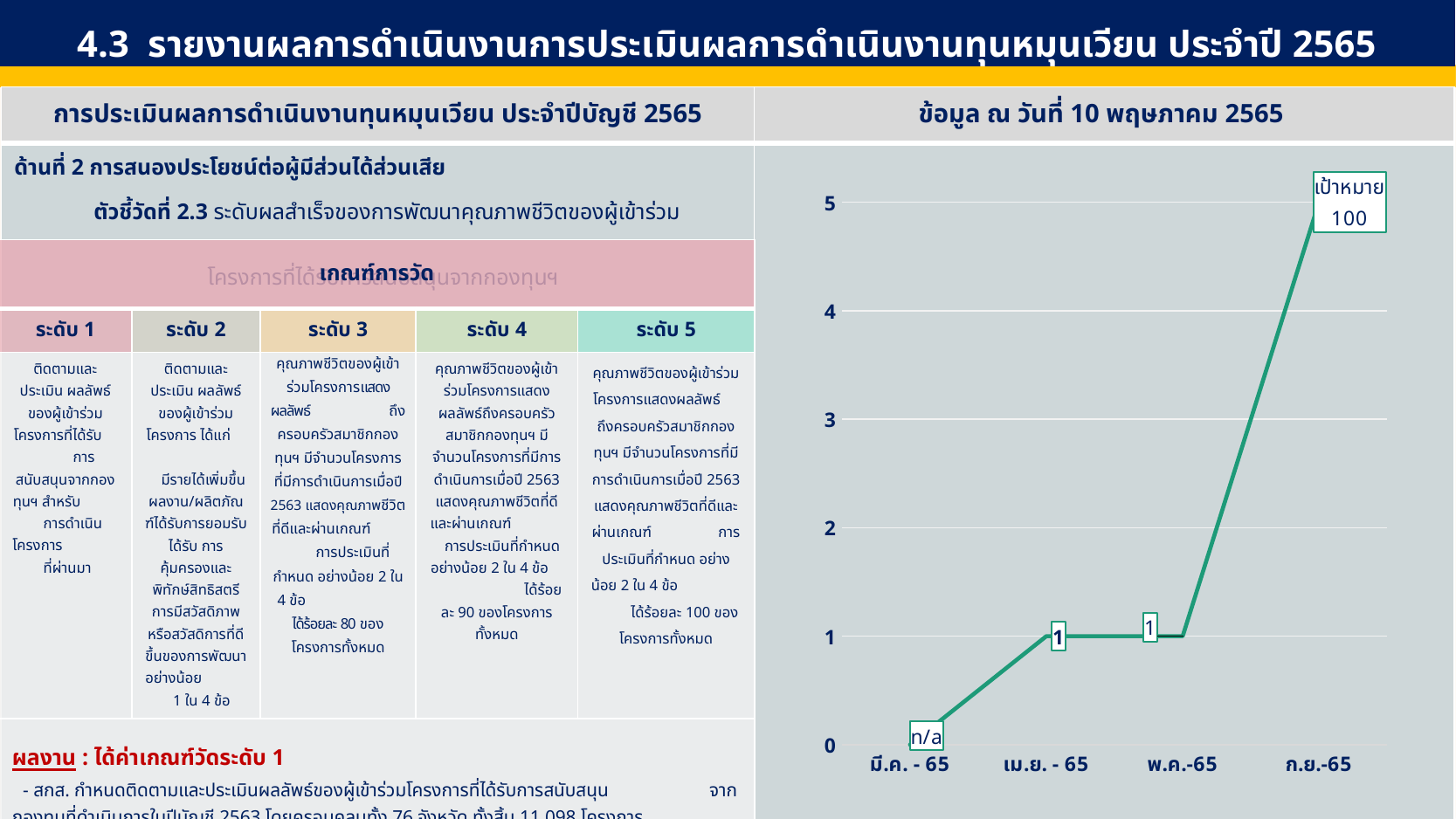
What kind of chart is shown on the right side of the slide? line chart What text is in the label box at the ก.ย.-65 point on the line chart? เป้าหมาย 100 Do the values on the line chart rise or fall from มี.ค. - 65 to ก.ย.-65? rise Is the value for ก.ย.-65 greater or less than 4? greater Which x-axis category has the highest point on the line chart? ก.ย.-65 What label is shown at the มี.ค. - 65 point on the line chart? n/a What value is labelled for เม.ย. - 65 on the line chart? 1 Which is larger on the line chart, the value for พ.ค.-65 or the value for ก.ย.-65? ก.ย.-65 What value is labelled for พ.ค.-65 on the line chart? 1 How many data points are plotted along the x axis of the line chart? 4 What is the highest tick value shown on the y axis of the line chart? 5